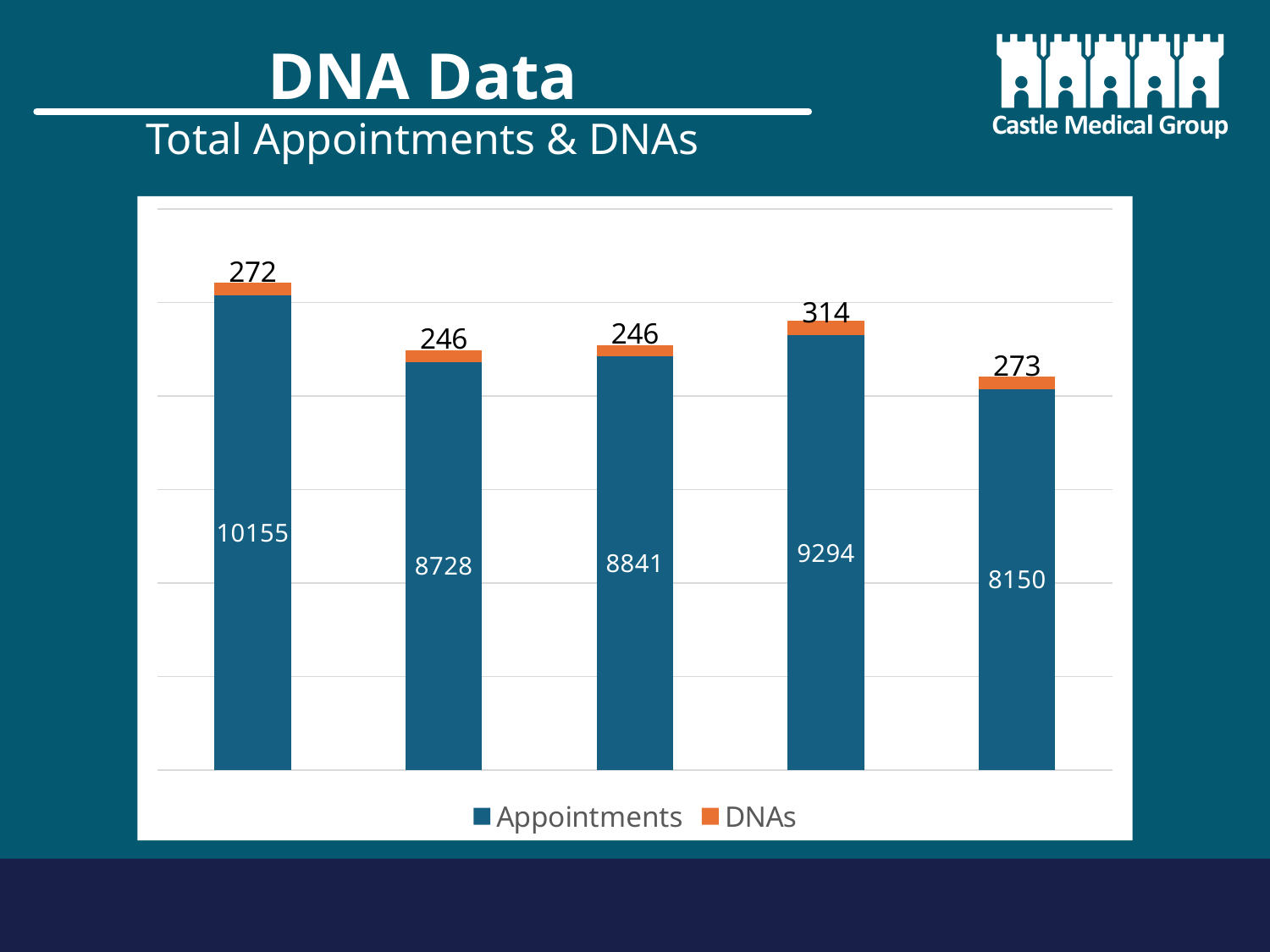
What is the difference in Appointments between the first bar and the second bar? 1427 Which bar has the highest DNAs value? The fourth bar What is the total of the fourth bar (Appointments plus DNAs)? 9608 What is the Appointments value for the last (rightmost) bar? 8150 Which bar has the lowest Appointments value? The fifth (rightmost) bar What is the Appointments value for the first (leftmost) bar? 10155 How many series does the legend list? 2 Which bar has the highest Appointments value? The first (leftmost) bar What type of chart is shown on the slide? Stacked bar chart Which series is shown in orange in the legend? DNAs How many bars are plotted in the chart? 5 What is the DNAs value for the fourth bar from the left? 314